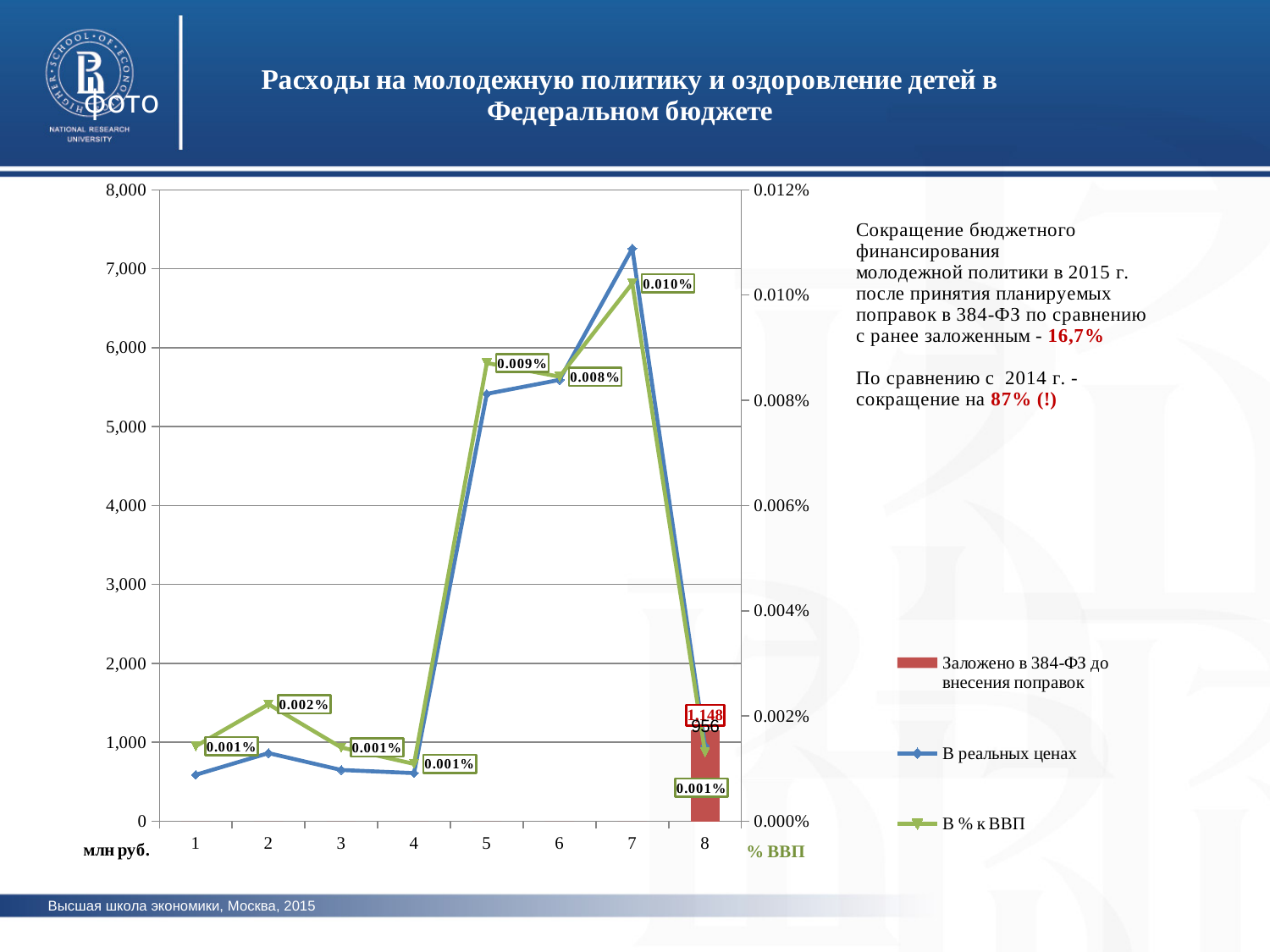
What is the value of the 'В % к ВВП' series at category 2? 0.002% What is the value of the 'В % к ВВП' series at category 7? 0.010% Is the value of 'В реальных ценах' at category 7 greater or less than 7,000? greater What is the value of the 'В % к ВВП' series at category 5? 0.009% What is the difference between the 'В % к ВВП' values at category 7 and category 6? 0.002% What is the value of the 'В % к ВВП' series at category 6? 0.008% Does the 'В реальных ценах' series rise or fall from category 4 to category 7? rise What is the value of the bar 'Заложено в 384-ФЗ до внесения поправок' at category 8? 1,148 How many categories are shown along the x axis of the chart? 8 At which category does the 'В % к ВВП' series reach its highest value? 7 Which is larger for the 'В реальных ценах' series: the value at category 7 or at category 5? category 7 How many series does the chart legend list? 3